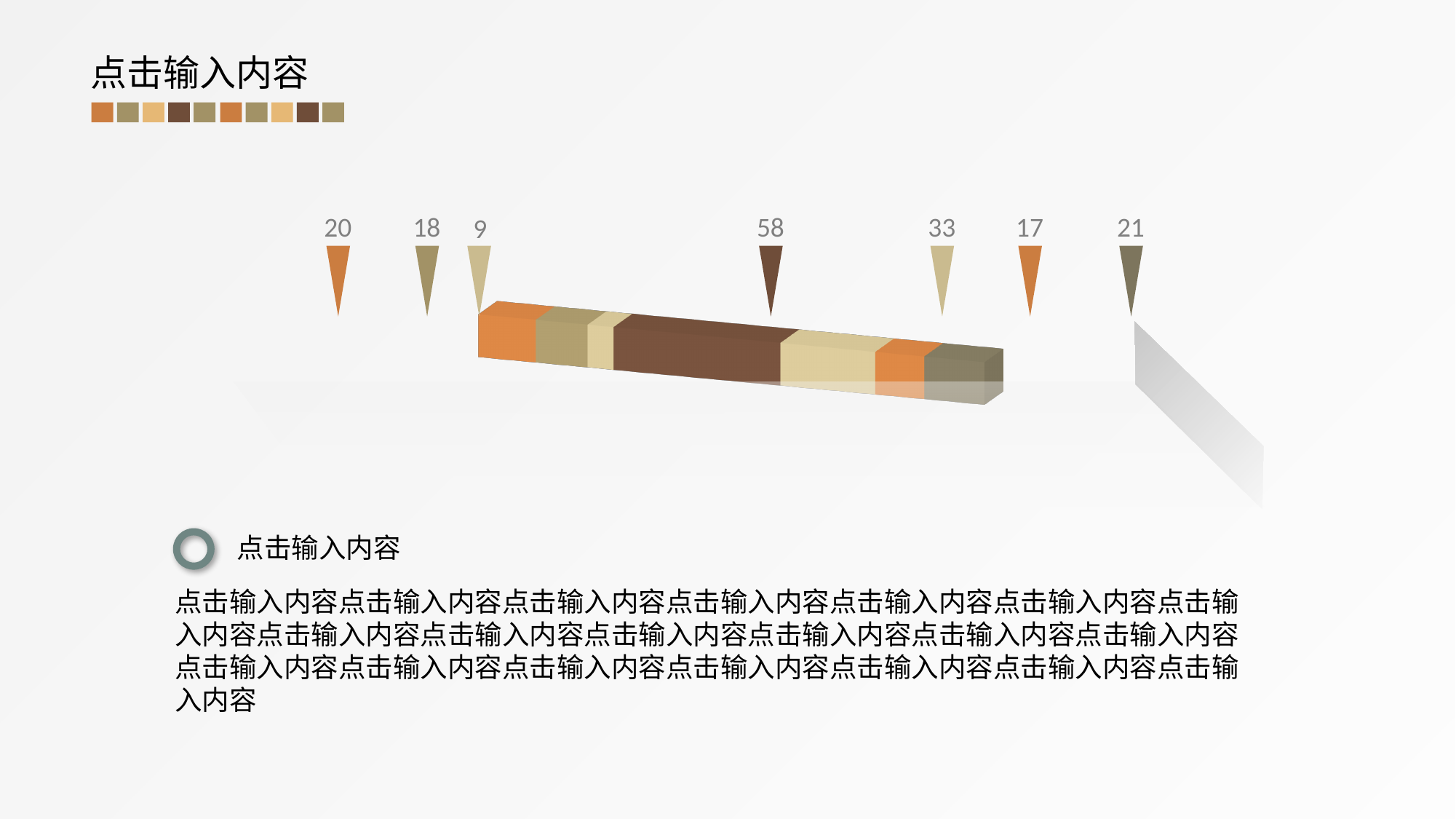
What is the value of the dark brown segment in the middle of the bar? 58 What is the difference between the largest segment value (58) and the second segment value (18)? 40 Which segment value is the lowest? 9 What colour is the segment with the value 58? Dark brown Which segment value is the highest? 58 What is the value of the third segment from the left? 9 What is the value of the first (leftmost) segment of the stacked bar? 20 Which is larger, the value of the fifth segment (33) or the value of the first segment (20)? 33 What kind of chart is shown on the slide? Stacked bar chart What is the total of all the segment values in the stacked bar? 176 How many segments make up the stacked bar? 7 What is the value of the last (rightmost) segment of the stacked bar? 21